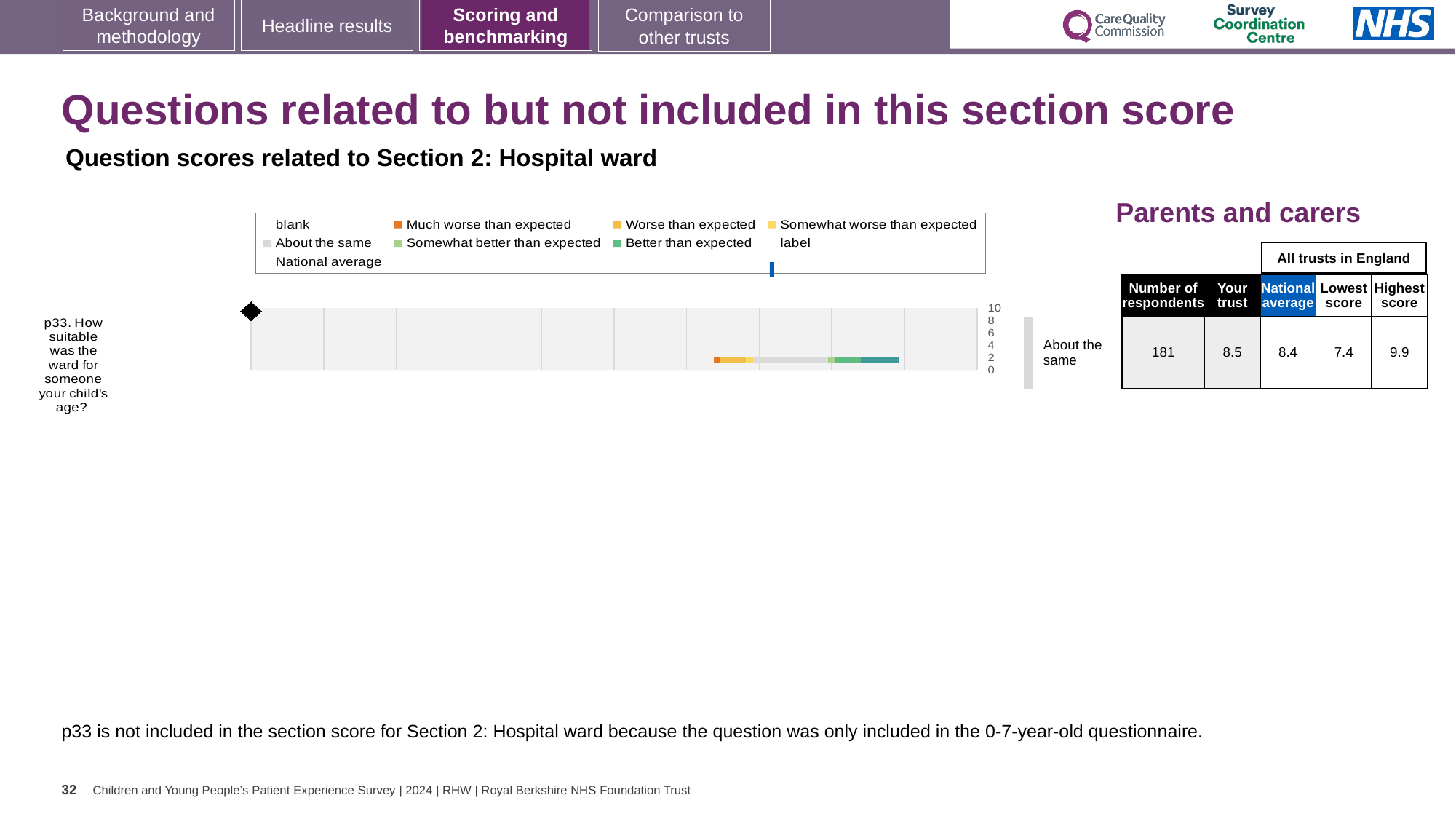
What is the difference between the highest score and the lowest score for p33? 2.5 What benchmark category label is shown to the right of the bar for p33? About the same What is the full label of the question plotted in the chart? p33. How suitable was the ward for someone your child's age? Which is higher for p33, the 'Your trust' score or the national average? Your trust What is the 'Your trust' score for p33 in the table beside the chart? 8.5 What is the highest score among all trusts in England for p33? 9.9 How many respondents answered p33? 181 What is the national average score for p33? 8.4 What kind of chart is used to show the p33 question score? bar chart What is the lowest score among all trusts in England for p33? 7.4 What is the difference between the 'Your trust' score and the national average for p33? 0.1 How many questions are plotted in the chart? 1